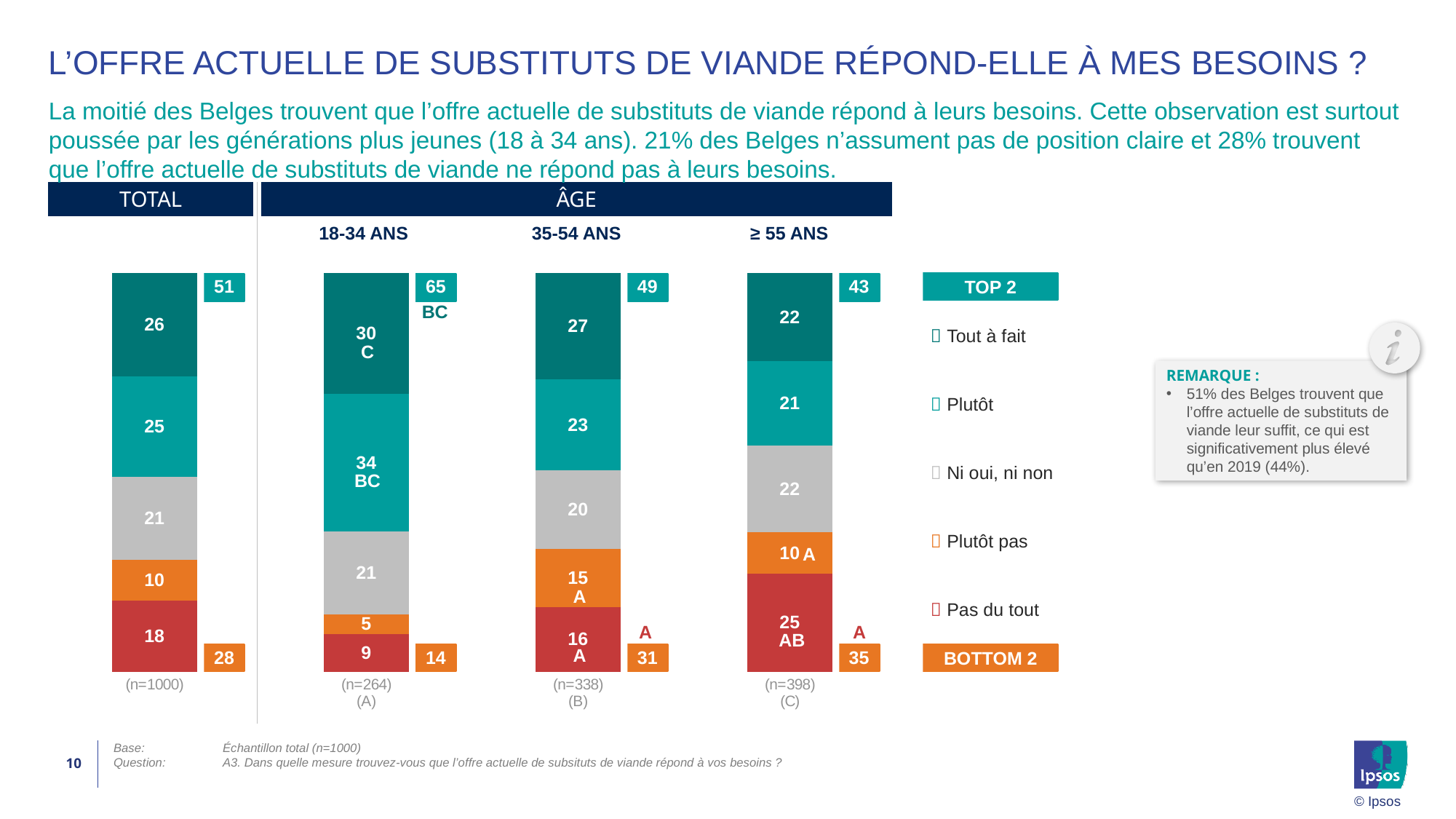
What kind of chart is shown on the slide? Stacked bar chart How many stacked bars are shown in the chart? 4 Which age group has the lowest BOTTOM 2 value? 18-34 ANS Is the 'Pas du tout' value larger for the 35-54 ANS group or the ≥ 55 ANS group? ≥ 55 ANS What is the sample size (n) for the 35-54 ANS group? n=338 What is the difference between the TOP 2 values of the 18-34 ANS and ≥ 55 ANS groups? 22 What is the BOTTOM 2 value for the ≥ 55 ANS group? 35 What is the TOP 2 value for the 18-34 ANS group? 65 How many response categories does the legend list? 5 What is the 'Plutôt pas' value for the 35-54 ANS group? 15 What is the 'Tout à fait' value for the TOTAL bar? 26 Which age group has the highest TOP 2 value? 18-34 ANS